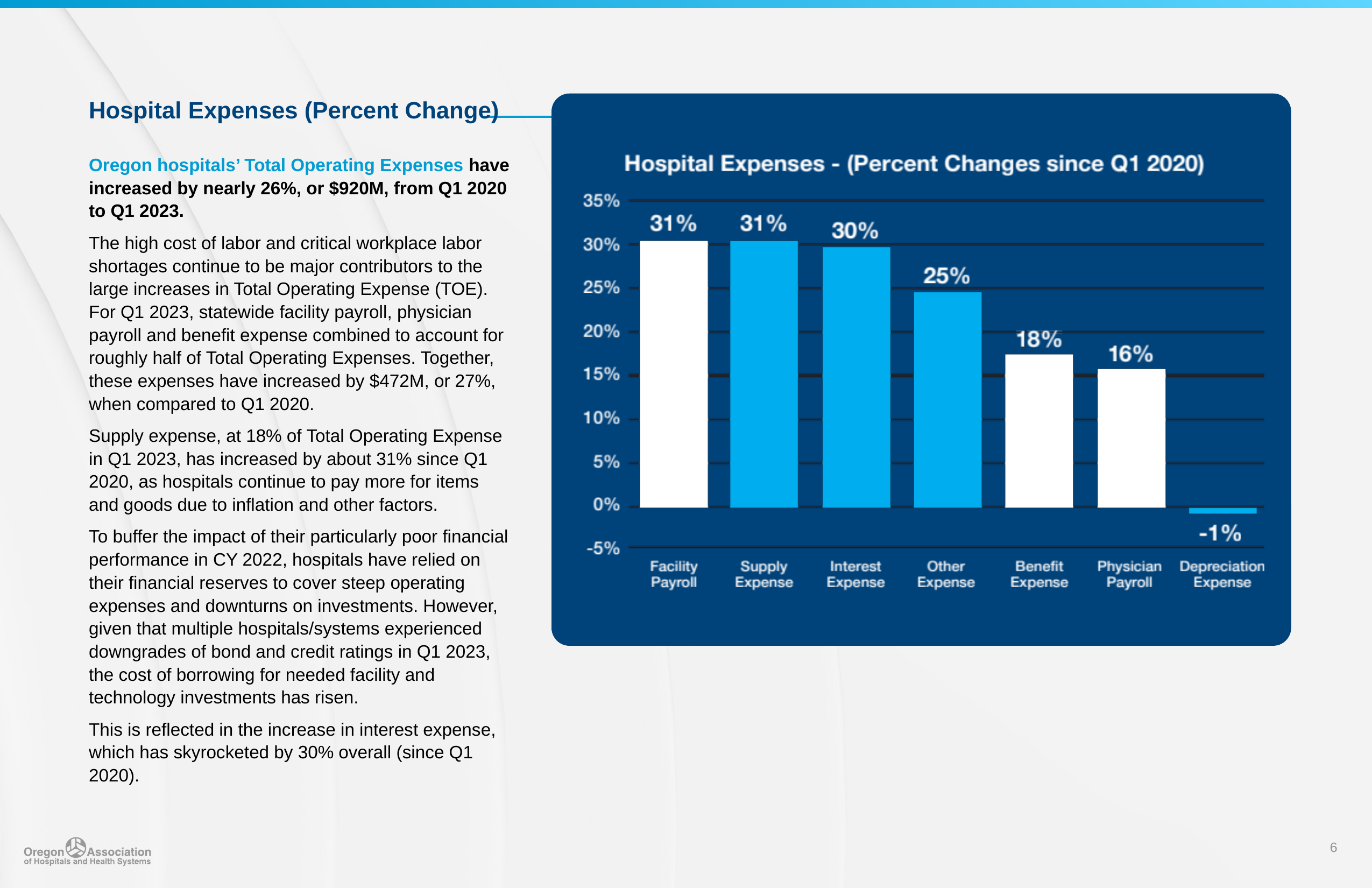
What is the percent change for Other Expense? 25% What is the title of the chart? Hospital Expenses - (Percent Changes since Q1 2020) What is the percent change for Physician Payroll? 16% Which is larger, the percent change for Other Expense or Benefit Expense? Other Expense Is the value for Supply Expense greater or less than 30%? greater What type of chart is shown on the slide? Bar chart What is the percent change for Depreciation Expense? -1% What is the difference between the percent change for Facility Payroll and Physician Payroll? 15% What is the percent change for Interest Expense? 30% Which category has the lowest percent change? Depreciation Expense What is the percent change for Benefit Expense? 18% How many expense categories are shown in the chart? 7